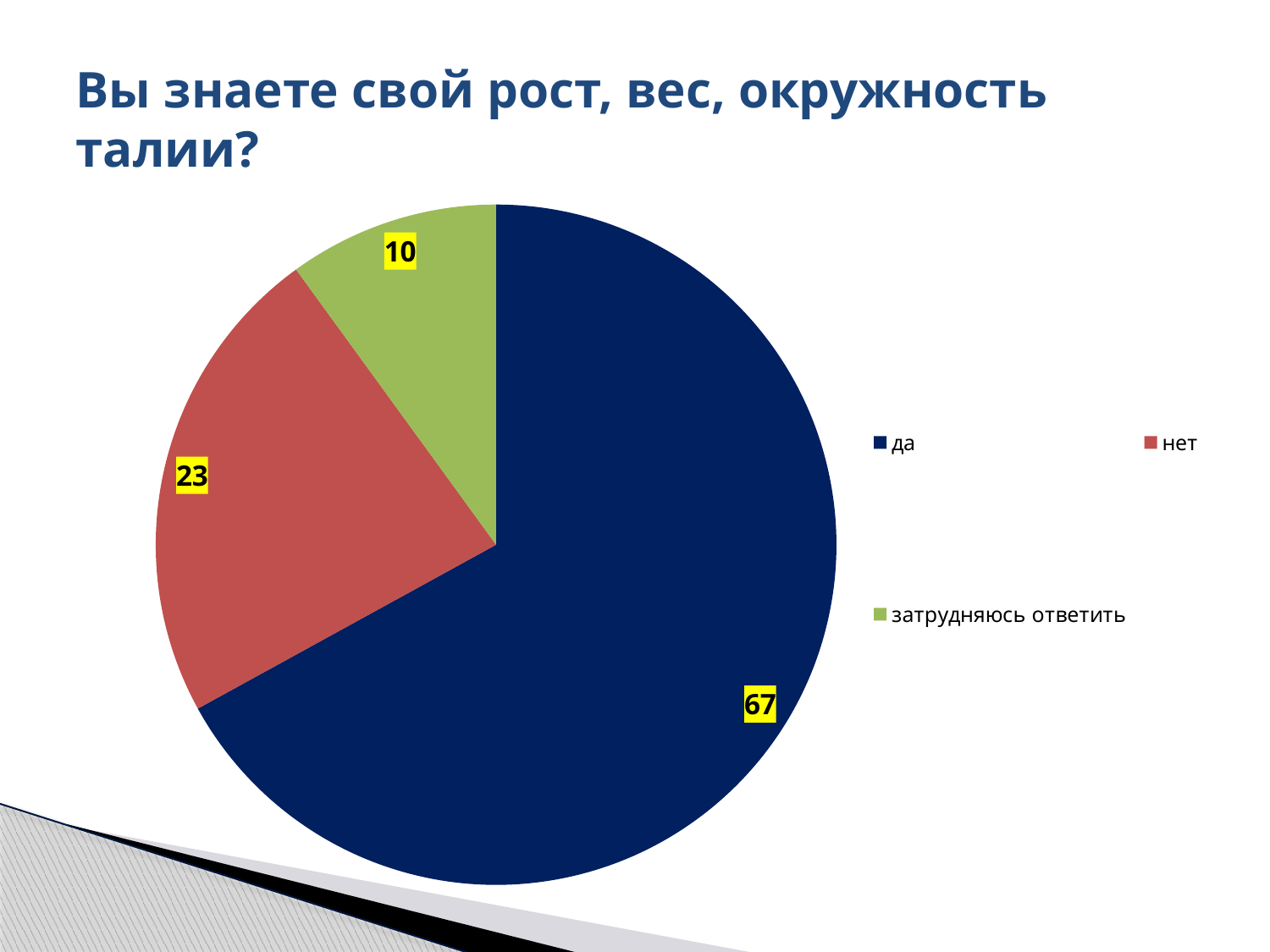
Which category has the largest slice? да Which category has the smallest slice? затрудняюсь ответить What type of chart is shown on the slide? pie chart What is the value for "нет"? 23 Which is larger, the value for "нет" or the value for "затрудняюсь ответить"? нет What is the value for "да"? 67 What is the value for "затрудняюсь ответить"? 10 What is the title of the slide? Вы знаете свой рост, вес, окружность талии? What is the difference between the values for "да" and "нет"? 44 What share of the pie does "да" represent? 67% How many categories does the pie chart have? 3 What is the difference between the values for "нет" and "затрудняюсь ответить"? 13